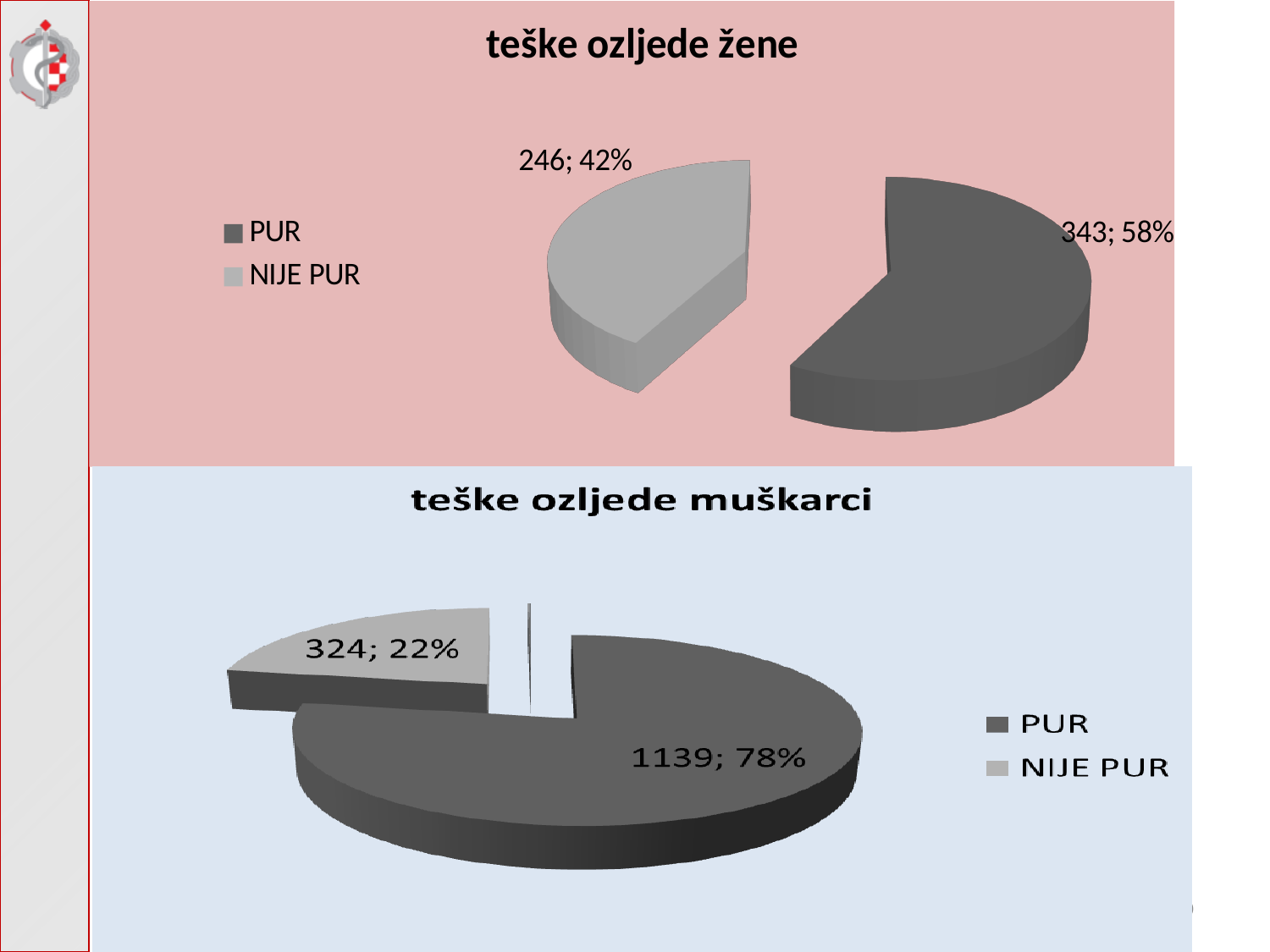
In the 'teške ozljede muškarci' chart, which slice is the smallest? NIJE PUR In the 'teške ozljede žene' chart, what is the difference between the PUR and NIJE PUR values? 97 In the 'teške ozljede muškarci' chart, what value is shown for NIJE PUR? 324 In the 'teške ozljede žene' chart, what value is shown for PUR? 343 In the 'teške ozljede žene' chart, what value is shown for NIJE PUR? 246 How many entries does the legend of the 'teške ozljede žene' chart list? 2 In the 'teške ozljede muškarci' chart, what is the difference between the PUR and NIJE PUR values? 815 In the 'teške ozljede muškarci' chart, what share of the pie is PUR? 78% In the 'teške ozljede žene' chart, which slice is larger, PUR or NIJE PUR? PUR In the 'teške ozljede žene' chart, what share of the pie is NIJE PUR? 42% In the 'teške ozljede muškarci' chart, what value is shown for PUR? 1139 What type of chart is the 'teške ozljede muškarci' chart? Pie chart